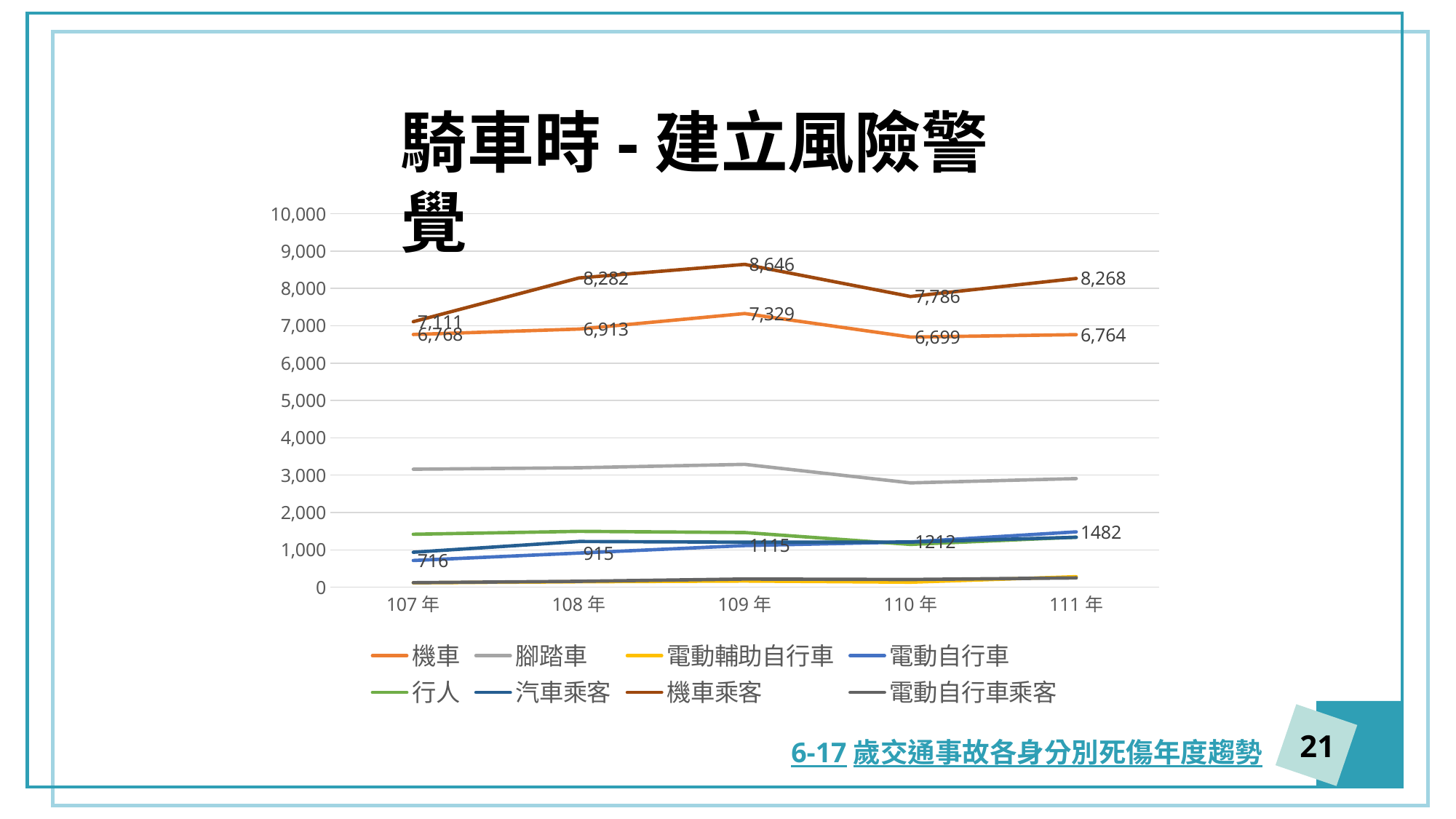
In which year is the 機車乘客 series highest? 109 年 What kind of chart is shown on the slide? line chart Is the value for 腳踏車 in 109 年 greater or less than 3,000? greater How many series does the legend list? 8 In which year is the 機車 series lowest? 110 年 Does the 電動自行車 series rise or fall from 107 年 to 111 年? rise What is the value for 機車 in 110 年? 6,699 What is the difference between 機車乘客 and 機車 in 108 年? 1,369 What is the value for 機車乘客 in 109 年? 8,646 What is the value for 電動自行車 in 111 年? 1482 How many years are shown on the x axis? 5 Which is larger in 107 年, 機車乘客 or 機車? 機車乘客